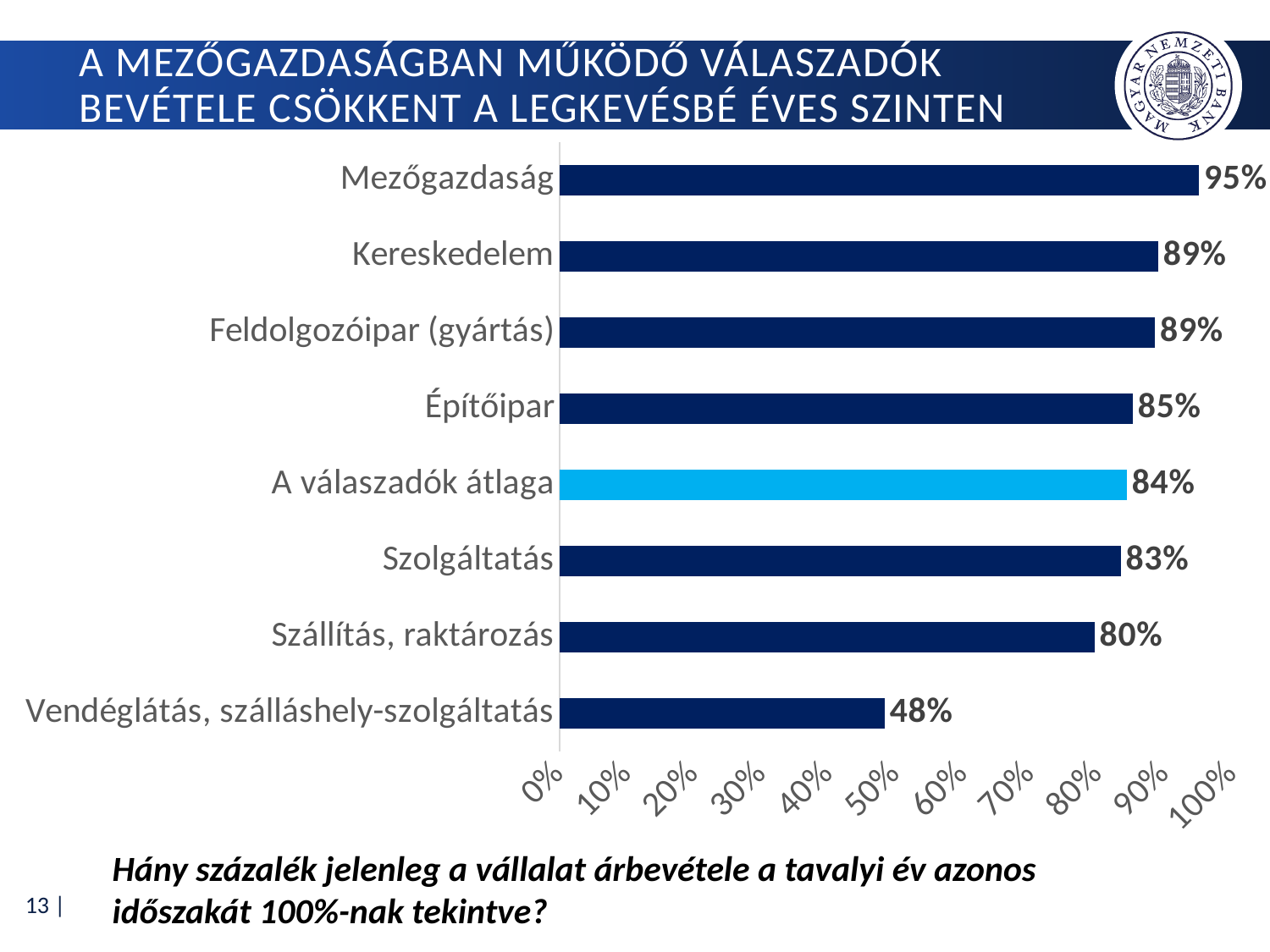
What kind of chart is shown on the slide? bar chart What is the value for Szállítás, raktározás? 80% What is the value for Vendéglátás, szálláshely-szolgáltatás? 48% What is the value for A válaszadók átlaga? 84% Which category has the lowest value? Vendéglátás, szálláshely-szolgáltatás Which category has the highest value? Mezőgazdaság What is the difference between the values for Mezőgazdaság and Vendéglátás, szálláshely-szolgáltatás? 47% How many categories are shown in the chart? 8 Which bar is shown in a lighter blue colour than the others? A válaszadók átlaga Is the value for Szállítás, raktározás greater or less than 70%? greater What is the value for Mezőgazdaság? 95% Which is larger, the value for Építőipar or the value for Szolgáltatás? Építőipar